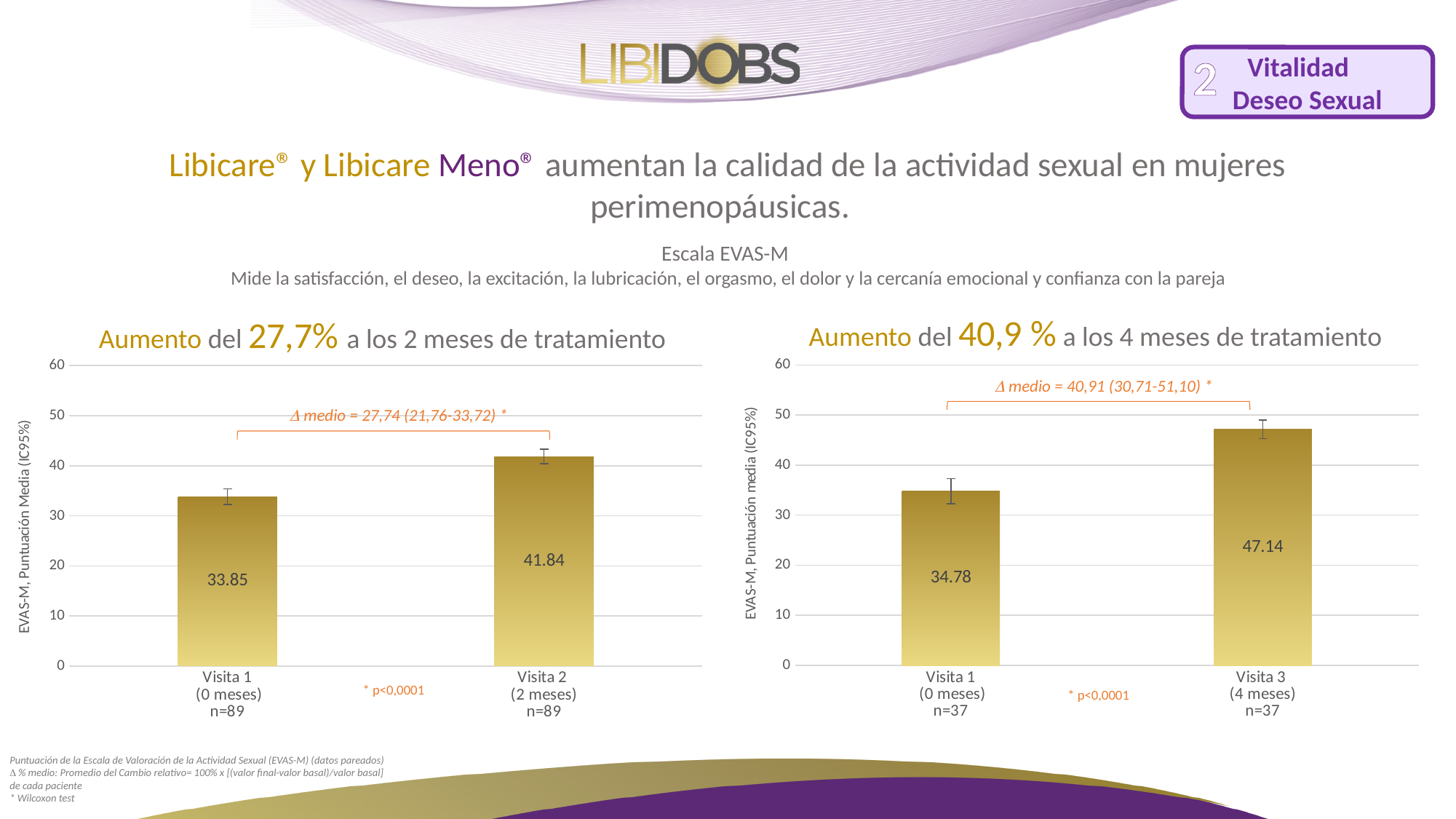
In the left chart (2 meses de tratamiento), what is the difference between the Visita 2 and Visita 1 values? 7.99 In the right chart (4 meses de tratamiento), what is the difference between the Visita 3 and Visita 1 values? 12.36 In the right chart (4 meses de tratamiento), what is the value for Visita 1 (0 meses)? 34.78 In the left chart (2 meses de tratamiento), what is the value for Visita 1 (0 meses)? 33.85 In the right chart (4 meses de tratamiento), which visit has the lower value? Visita 1 (0 meses) In the left chart (2 meses de tratamiento), what is the value for Visita 2 (2 meses)? 41.84 In the right chart (4 meses de tratamiento), is the value for Visita 3 (4 meses) greater or less than 40? greater In the left chart (2 meses de tratamiento), which visit has the higher value? Visita 2 (2 meses) What kind of chart is the right chart (4 meses de tratamiento)? Bar chart In the right chart (4 meses de tratamiento), what is the value for Visita 3 (4 meses)? 47.14 What is the y-axis label of the left chart (2 meses de tratamiento)? EVAS-M, Puntuación Media (IC95%) How many bars are plotted in the left chart (2 meses de tratamiento)? 2